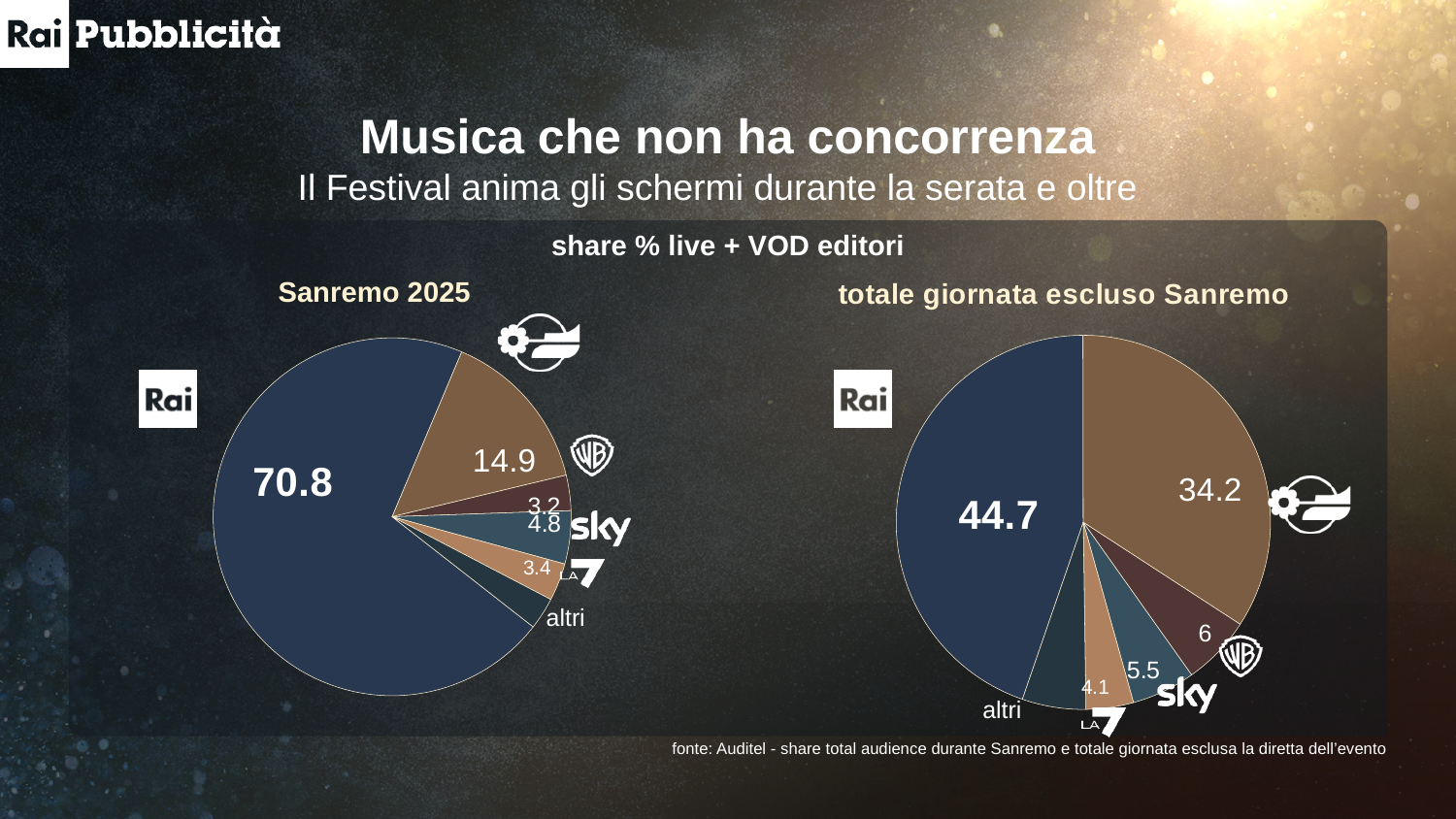
In the 'totale giornata escluso Sanremo' pie chart, what is the share for Rai? 44.7 In the Sanremo 2025 pie chart, what is the share for Rai? 70.8 Is Sky's share larger in the Sanremo 2025 chart or in the 'totale giornata escluso Sanremo' chart? totale giornata escluso Sanremo In the 'totale giornata escluso Sanremo' pie chart, what is the share for La7? 4.1 In the Sanremo 2025 pie chart, what is the difference between the Sky share and the La7 share? 1.4 In the Sanremo 2025 pie chart, what is the share for Sky? 4.8 How much higher is Rai's share in the Sanremo 2025 chart than in the 'totale giornata escluso Sanremo' chart? 26.1 In the 'totale giornata escluso Sanremo' pie chart, what is the share for Sky? 5.5 In the Sanremo 2025 pie chart, what is the share for La7? 3.4 In the Sanremo 2025 pie chart, which broadcaster has the largest slice? Rai What kind of charts are shown on the slide? Pie charts How many slices does the Sanremo 2025 pie chart have? 6